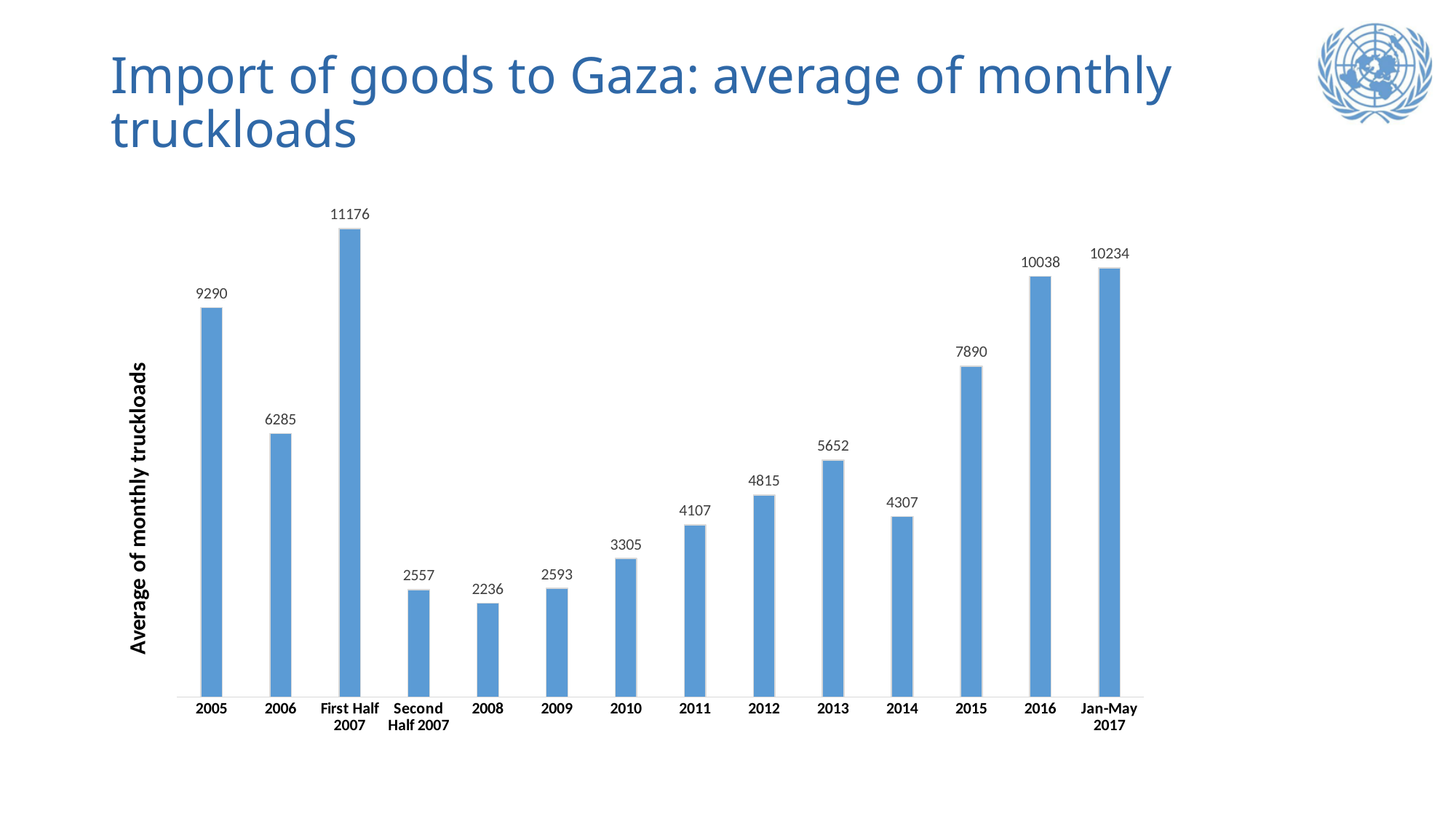
Which category has the highest average of monthly truckloads? First Half 2007 What is the average of monthly truckloads for Jan-May 2017? 10234 Do the values rise or fall from 2008 to 2013? Rise What is the average of monthly truckloads for 2005? 9290 What is the difference in average monthly truckloads between 2016 and 2015? 2148 What is the average of monthly truckloads for the Second Half 2007? 2557 What is the label of the vertical axis of the chart? Average of monthly truckloads Which is larger, the average of monthly truckloads for 2012 or for 2014? 2012 How many categories are shown on the x axis of the chart? 14 What kind of chart is shown on the slide? Bar chart What is the difference in average monthly truckloads between 2013 and 2014? 1345 Which category has the lowest average of monthly truckloads? 2008